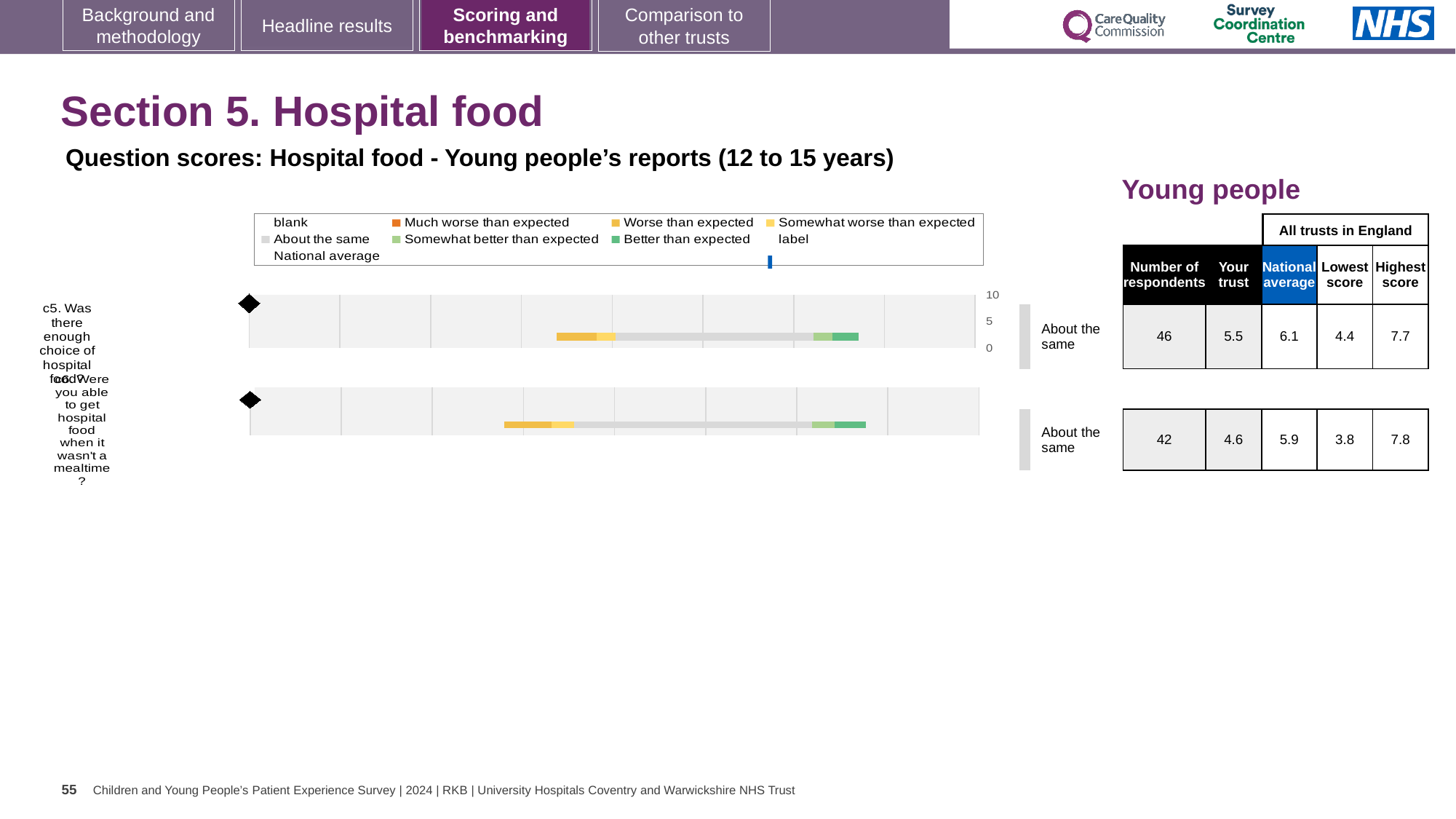
What is the 'Your trust' score for question c5 (Was there enough choice of hospital food?)? 5.5 How many questions (bars) are plotted in the hospital food chart? 2 Is the trust's score for question c6 greater or less than 5? less What is the maximum value shown on the chart's score axis? 10 What is the difference between the national average and the trust's score for question c6? 1.3 What is the national average score for question c5? 6.1 What kind of chart is used to show the question scores for hospital food? bar chart Which question has the higher 'Your trust' score, c5 or c6? c5 What is the national average score for question c6? 5.9 How many respondents answered question c5? 46 What is the 'Your trust' score for question c6 (Were you able to get hospital food when it wasn't a mealtime?)? 4.6 What is the highest score among all trusts in England for question c6? 7.8